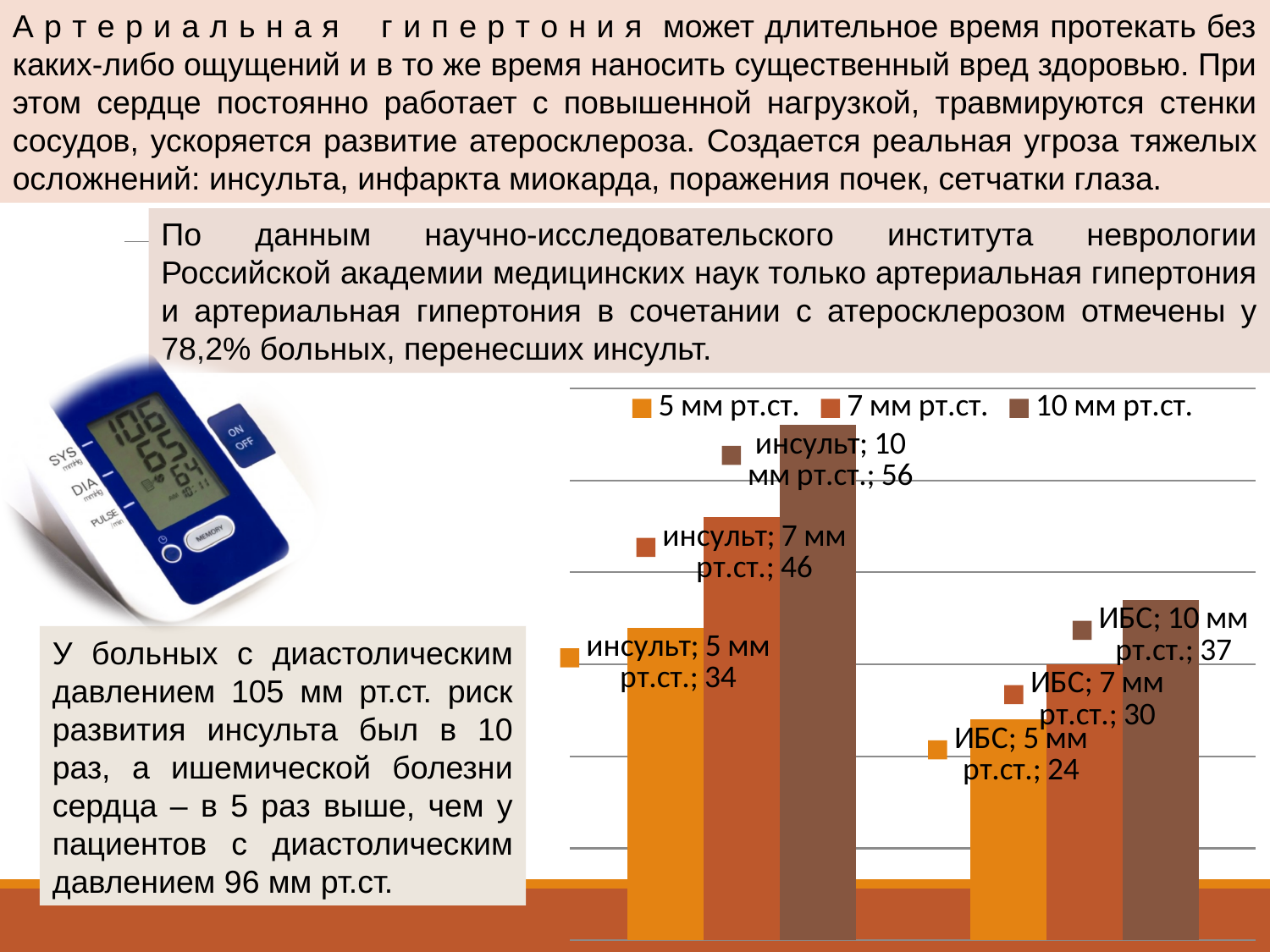
What is the difference between the 10 мм рт.ст. values for инсульт and ИБС? 19 Which bar has the highest value on the chart? инсульт; 10 мм рт.ст. What is the value for инсульт in the 7 мм рт.ст. series? 46 What is the value for ИБС in the 5 мм рт.ст. series? 24 What is the value for ИБС in the 10 мм рт.ст. series? 37 Which bar has the lowest value on the chart? ИБС; 5 мм рт.ст. What type of chart is shown on the slide? bar chart Which is larger: the 5 мм рт.ст. value for инсульт or the 7 мм рт.ст. value for ИБС? инсульт, 5 мм рт.ст. What are the three series names listed in the chart legend? 5 мм рт.ст., 7 мм рт.ст., 10 мм рт.ст. What is the value for инсульт in the 10 мм рт.ст. series? 56 How many categories are shown on the chart? 2 How many series does the chart legend list? 3